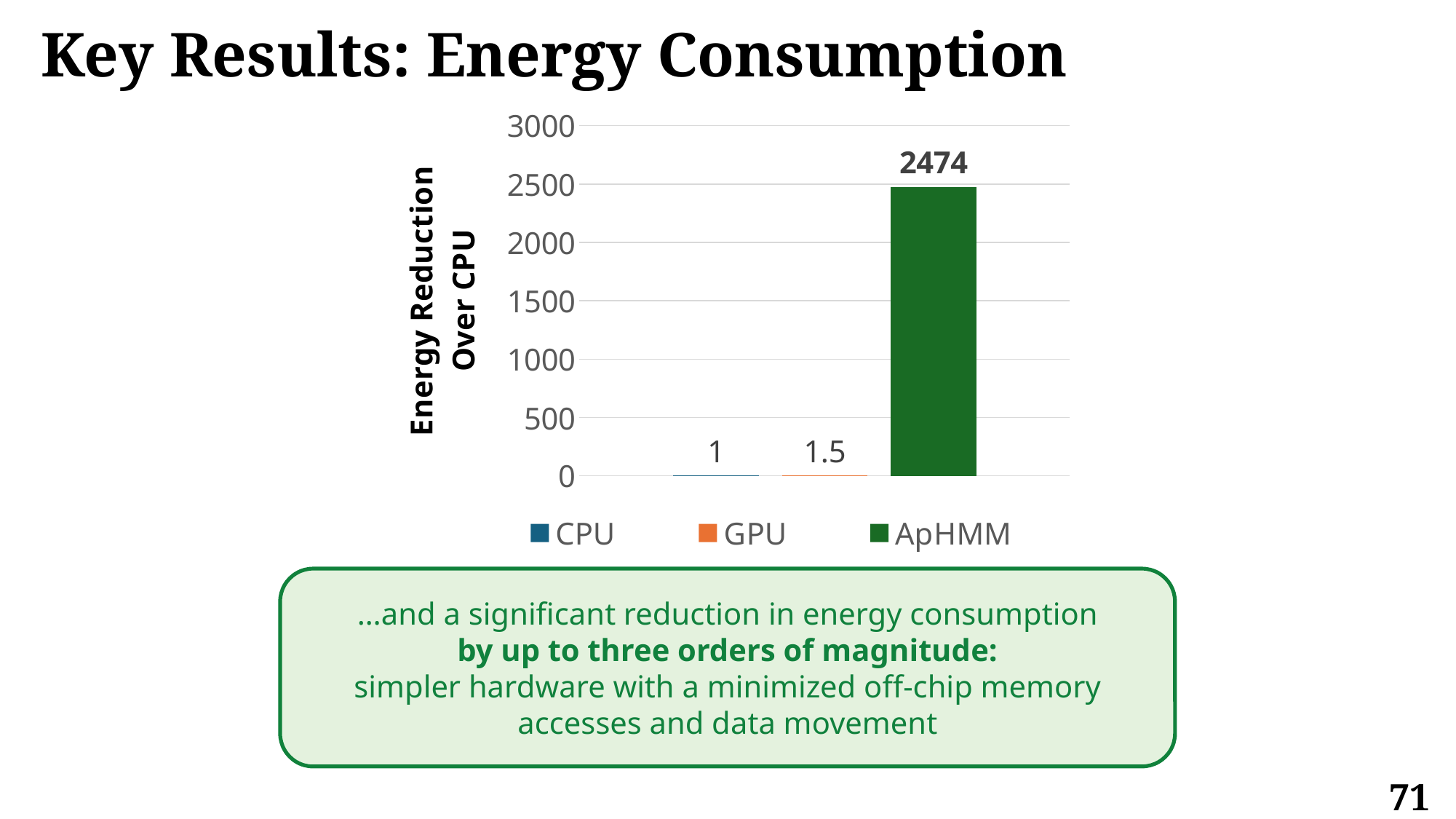
What is the difference between the GPU value and the CPU value? 0.5 Which is larger, the value for ApHMM or the value for GPU? ApHMM Is the value for ApHMM greater or less than 2000? greater What is the label on the vertical axis of the chart? Energy Reduction Over CPU What is the difference between the ApHMM value and the GPU value? 2472.5 How many series does the legend list? 3 Which series has the highest energy reduction over CPU? ApHMM What kind of chart is shown on the slide? bar chart What is the energy reduction over CPU value shown for GPU? 1.5 Which series has the lowest energy reduction over CPU? CPU What is the energy reduction over CPU value shown for ApHMM? 2474 What is the energy reduction over CPU value shown for CPU? 1